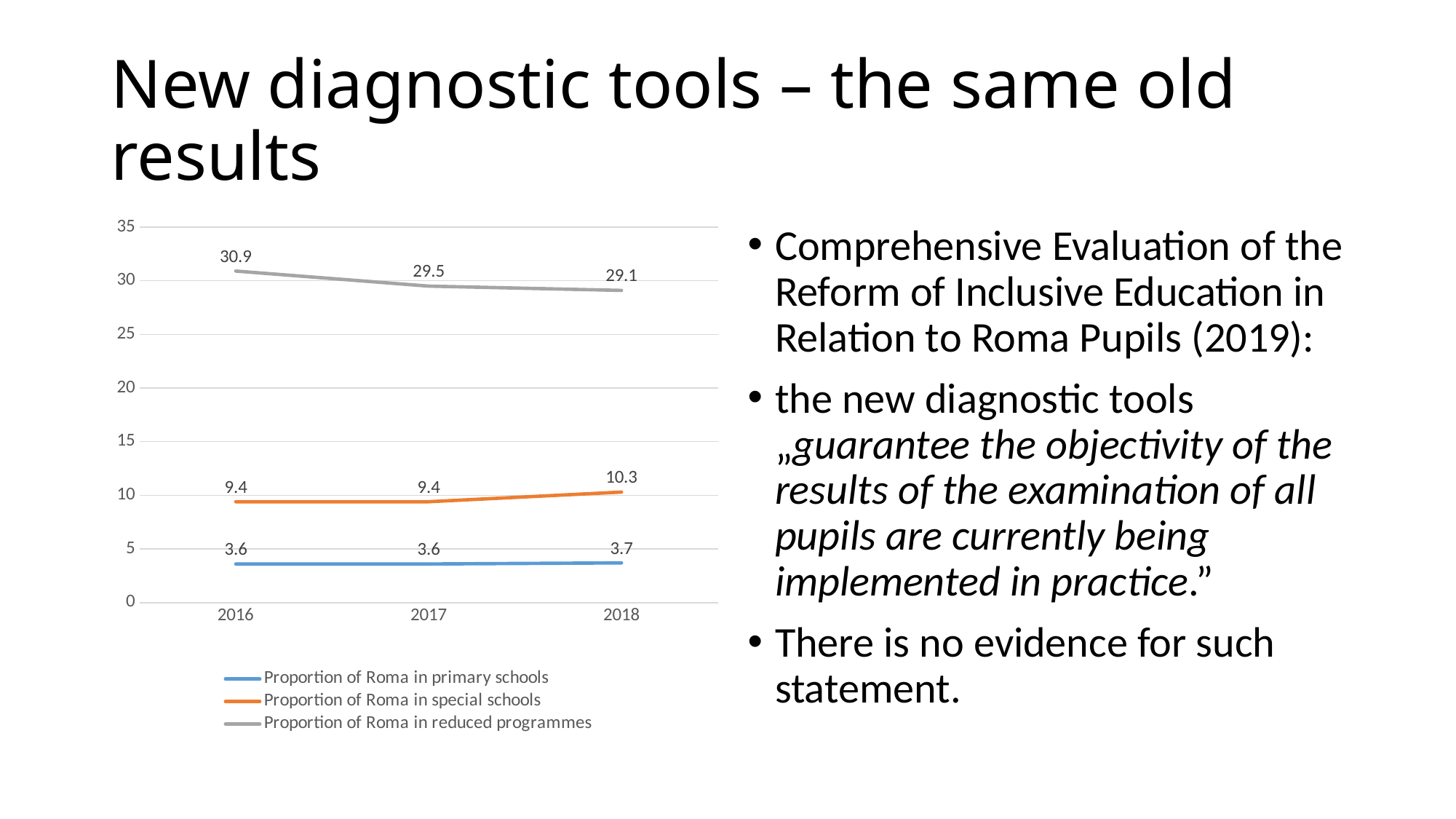
In which year is the proportion of Roma in reduced programmes highest? 2016 In which year is the proportion of Roma in reduced programmes lowest? 2018 What is the difference between the proportion of Roma in reduced programmes in 2016 and in 2018? 1.8 What is the proportion of Roma in reduced programmes in 2016? 30.9 What is the proportion of Roma in special schools in 2018? 10.3 Is the proportion of Roma in reduced programmes in 2017 greater or less than 25? greater How many years are shown on the x axis? 3 Which is larger in 2018: the proportion of Roma in special schools or the proportion of Roma in primary schools? Proportion of Roma in special schools What kind of chart is shown on the slide? Line chart Does the proportion of Roma in reduced programmes rise or fall from 2016 to 2018? Fall How many series does the legend list? 3 What is the proportion of Roma in primary schools in 2017? 3.6